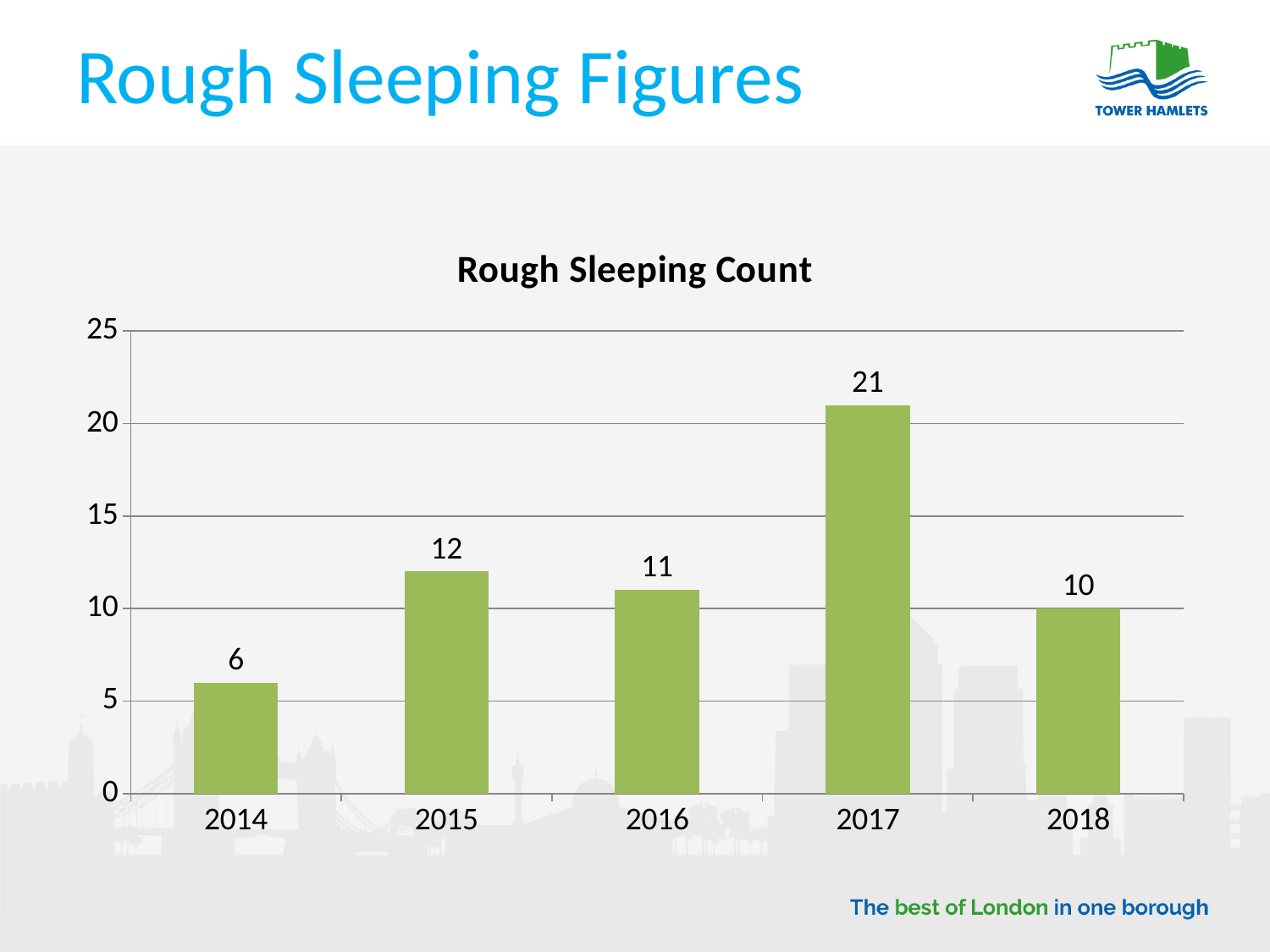
Which year has a higher rough sleeping count, 2015 or 2018? 2015 What is the title of the chart? Rough Sleeping Count Is the value for 2017 greater or less than 20? greater What is the rough sleeping count for 2017? 21 What is the difference between the rough sleeping counts for 2015 and 2014? 6 Which year has the highest rough sleeping count? 2017 What is the rough sleeping count for 2014? 6 What is the rough sleeping count for 2018? 10 What kind of chart is shown on the slide? Bar chart How many years are shown on the chart? 5 Which year has the lowest rough sleeping count? 2014 What is the difference between the rough sleeping counts for 2017 and 2016? 10